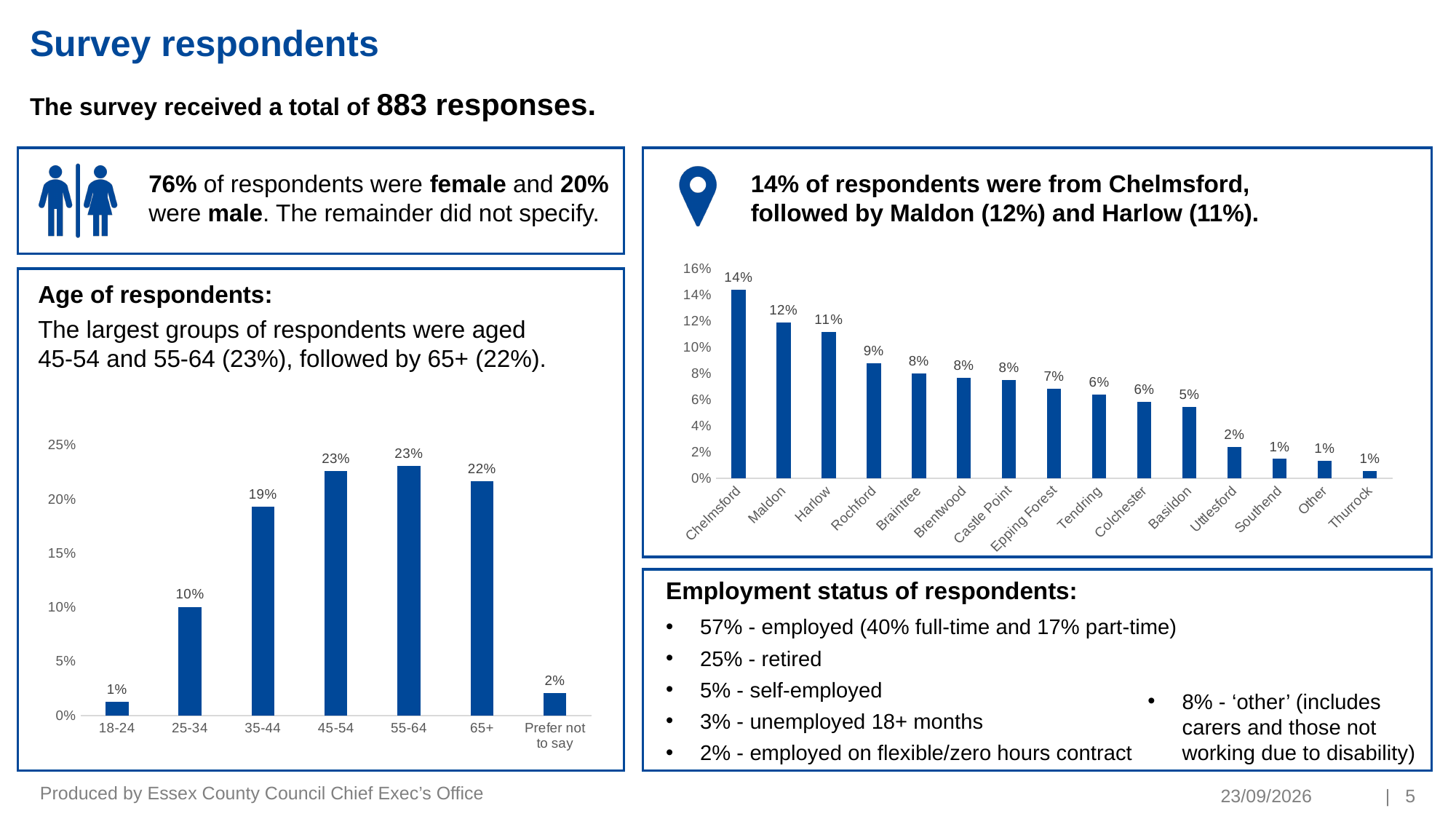
In the age of respondents chart on the left, how many categories are shown on the x axis? 7 In the age of respondents chart on the left, which is larger: the value for 35-44 or the value for 65+? 65+ In the age of respondents chart on the left, what percentage of respondents were aged 65+? 22% In the location chart on the right, how many areas are shown on the x axis? 15 In the location chart on the right, what percentage of respondents were from Basildon? 5% In the age of respondents chart on the left, what is the difference between the 35-44 and 25-34 percentages? 9% In the age of respondents chart on the left, what percentage of respondents were aged 25-34? 10% In the location chart on the right, which area has the highest percentage of respondents? Chelmsford In the age of respondents chart on the left, which age group has the lowest percentage? 18-24 In the location chart on the right, what is the difference between the Chelmsford and Harlow percentages? 3% What type of chart is the location chart on the right? Bar chart In the location chart on the right, what percentage of respondents were from Rochford? 9%